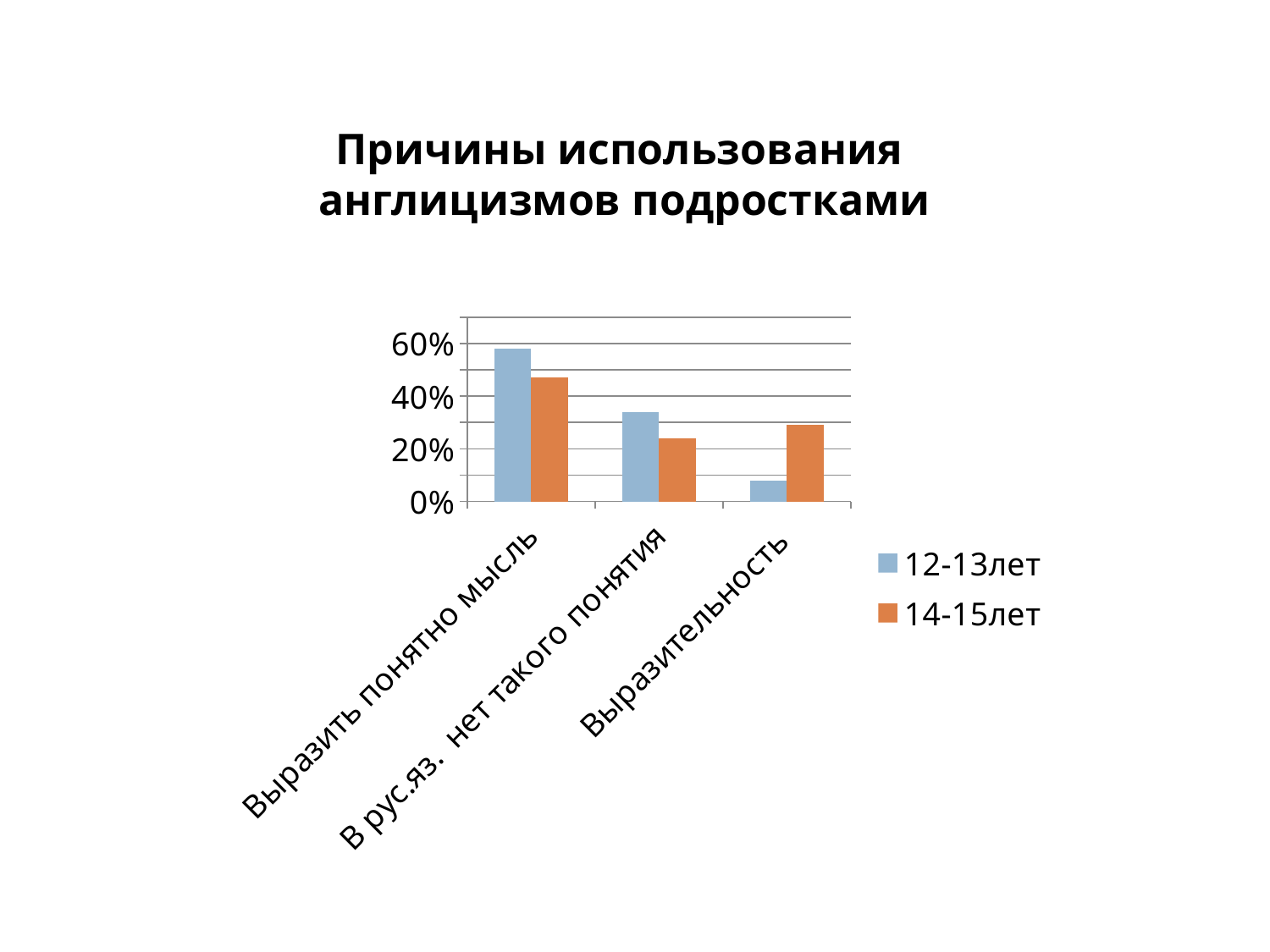
For the category Выразить понятно мысль, which series has the larger value, 12-13лет or 14-15лет? 12-13лет Is the value for 12-13лет in the category Выразительность greater or less than 20%? less Which category has the highest value for the 12-13лет series? Выразить понятно мысль What is the title of the chart on the slide? Причины использования англицизмов подростками Which category has the highest value for the 14-15лет series? Выразить понятно мысль Is the value for 14-15лет in the category Выразить понятно мысль greater or less than 40%? greater Which category has the lowest value for the 12-13лет series? Выразительность How many categories are shown on the x axis of the chart? 3 Which category has the lowest value for the 14-15лет series? В рус.яз. нет такого понятия For the category Выразительность, which series has the larger value, 12-13лет or 14-15лет? 14-15лет How many series does the chart's legend list? 2 What kind of chart is shown on the slide? bar chart